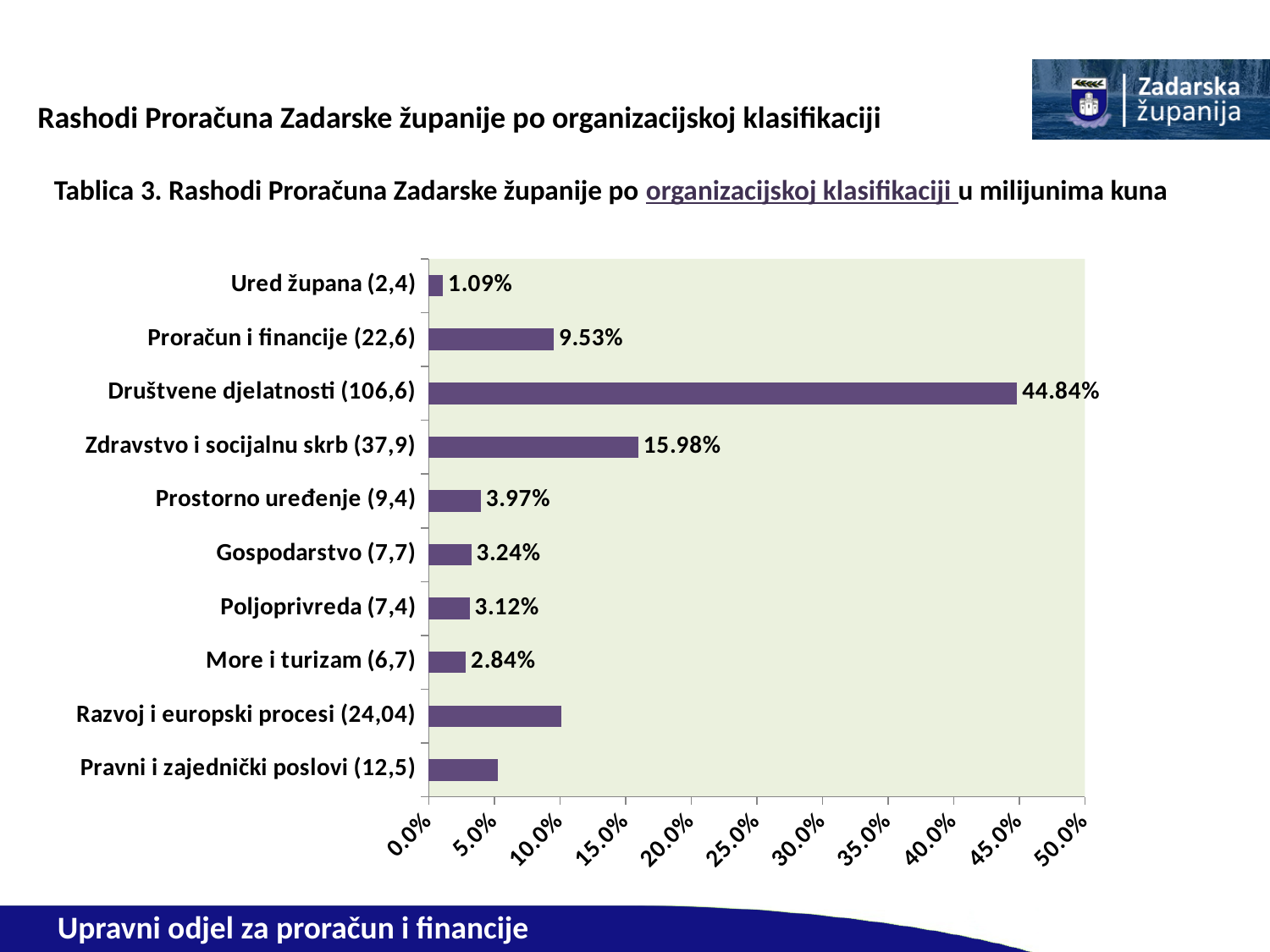
Which is larger, the value for Gospodarstvo (7,7) or the value for Poljoprivreda (7,4)? Gospodarstvo (7,7) Is the value for Pravni i zajednički poslovi (12,5) greater or less than 10.0%? less Which category has the lowest value in the chart? Ured župana (2,4) What is the value shown for Društvene djelatnosti (106,6)? 44.84% Is the value for Razvoj i europski procesi (24,04) greater or less than 15.0%? less What is the value shown for Ured župana (2,4)? 1.09% What is the value shown for Zdravstvo i socijalnu skrb (37,9)? 15.98% Which category has the highest value in the chart? Društvene djelatnosti (106,6) What is the difference between the values for Proračun i financije (22,6) and Prostorno uređenje (9,4)? 5.56% What kind of chart is shown on the slide? bar chart What is the value shown for More i turizam (6,7)? 2.84% How many categories are plotted in the chart? 10